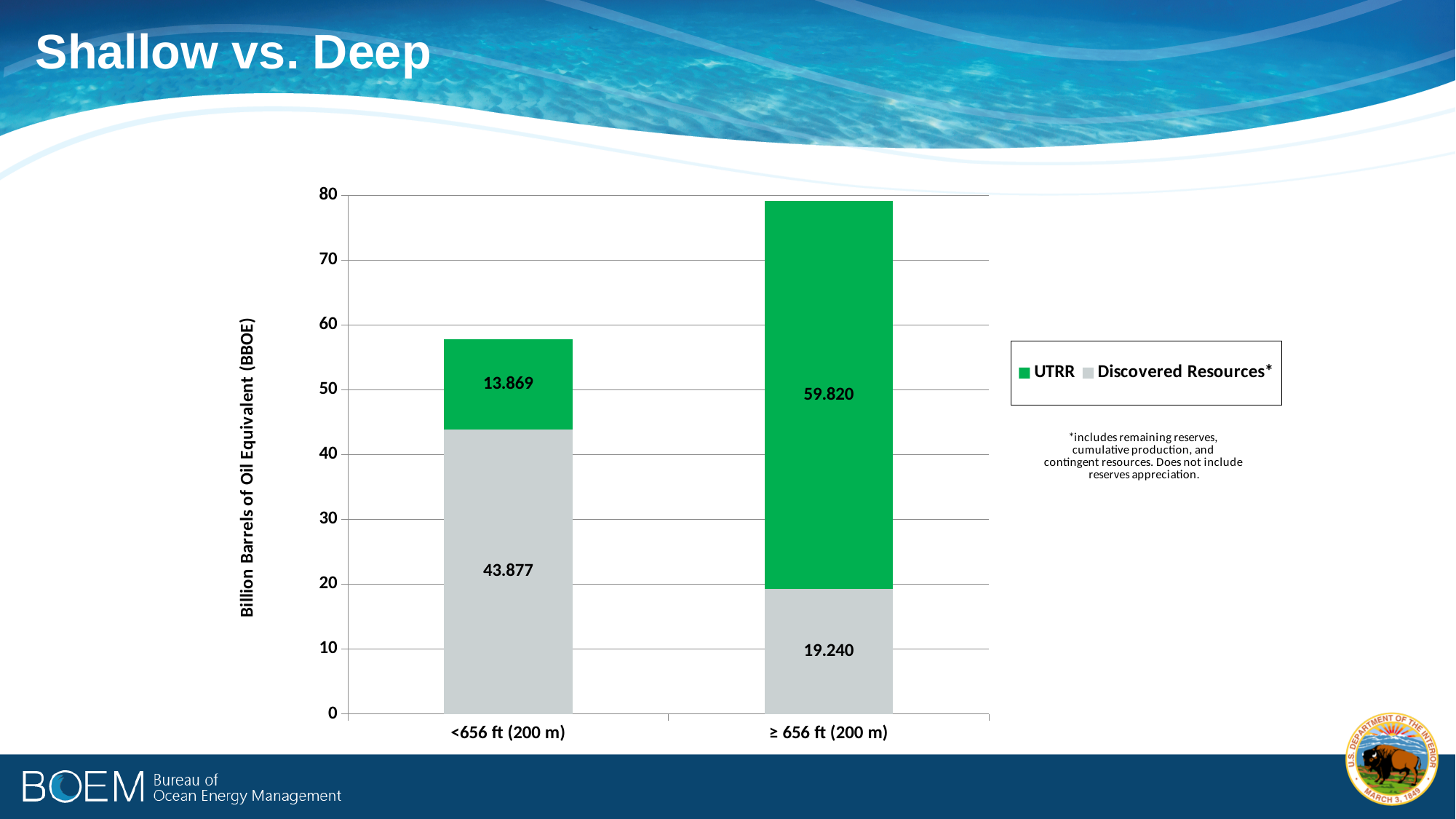
What is the difference between the UTRR values for ≥ 656 ft (200 m) and <656 ft (200 m)? 45.951 What type of chart is shown on the slide? Stacked bar chart What is the UTRR value for the <656 ft (200 m) category? 13.869 Which category has the lower Discovered Resources* value? ≥ 656 ft (200 m) Is the Discovered Resources* value for <656 ft (200 m) larger or smaller than the UTRR value for the same category? larger What is the total height of the stacked bar for ≥ 656 ft (200 m)? 79.060 What is the Discovered Resources* value for the ≥ 656 ft (200 m) category? 19.240 What is the total height of the stacked bar for <656 ft (200 m)? 57.746 What is the UTRR value for the ≥ 656 ft (200 m) category? 59.820 Which category has the higher UTRR value? ≥ 656 ft (200 m) How many series does the legend list? 2 What is the Discovered Resources* value for the <656 ft (200 m) category? 43.877